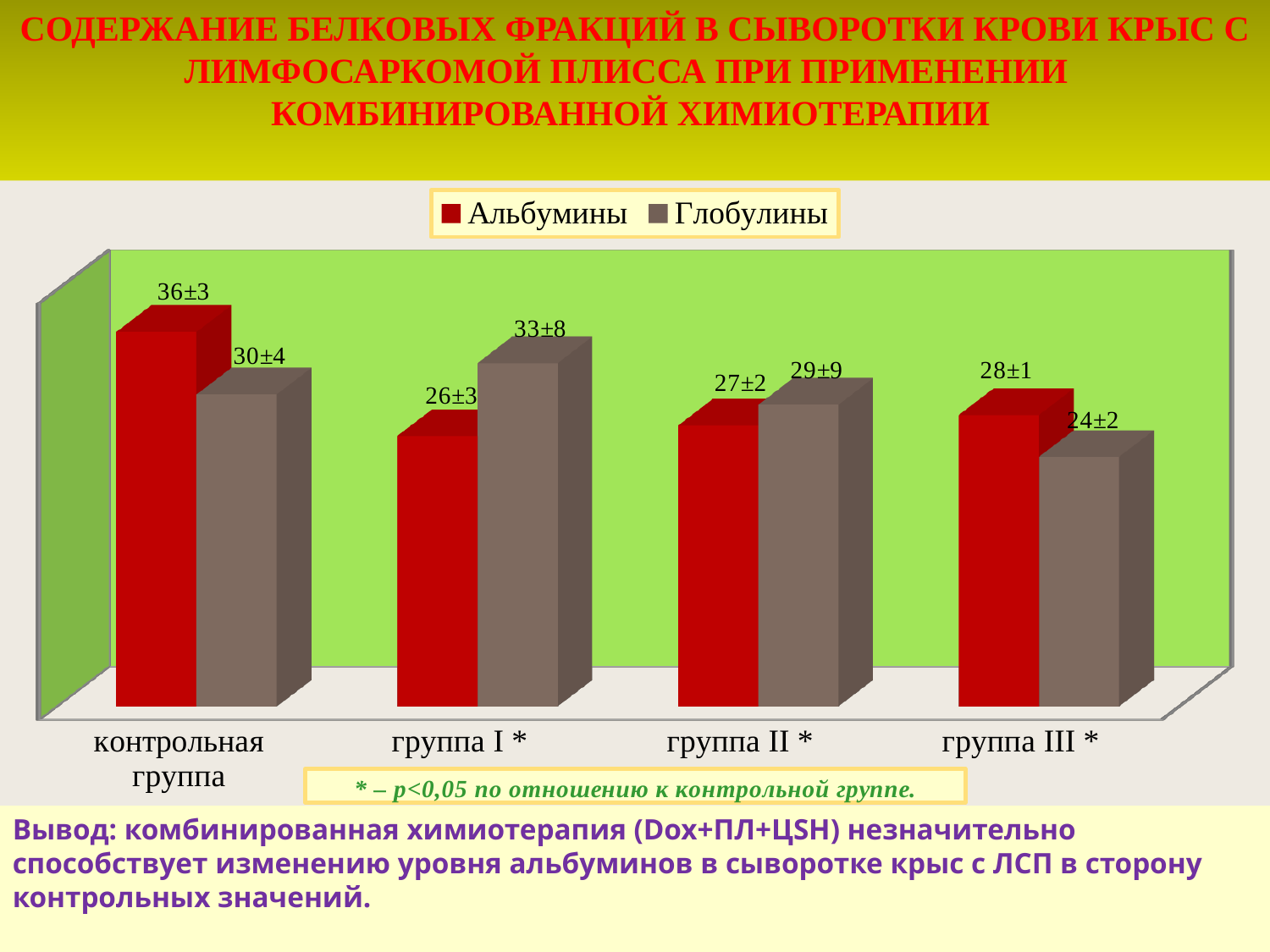
What is the Глобулины value for группа III *? 24±2 What is the Глобулины value for the контрольная группа? 30±4 Which group has the lowest Глобулины value? группа III * How many groups are shown on the x axis? 4 What is the Альбумины value for the контрольная группа? 36±3 What is the Альбумины value for группа II *? 27±2 How many series does the legend list? 2 What is the Глобулины value for группа I *? 33±8 In группа I *, which is larger: Альбумины or Глобулины? Глобулины What kind of chart is shown on the slide? bar chart Which group has the lowest Альбумины value? группа I * Which group has the highest Альбумины value? контрольная группа